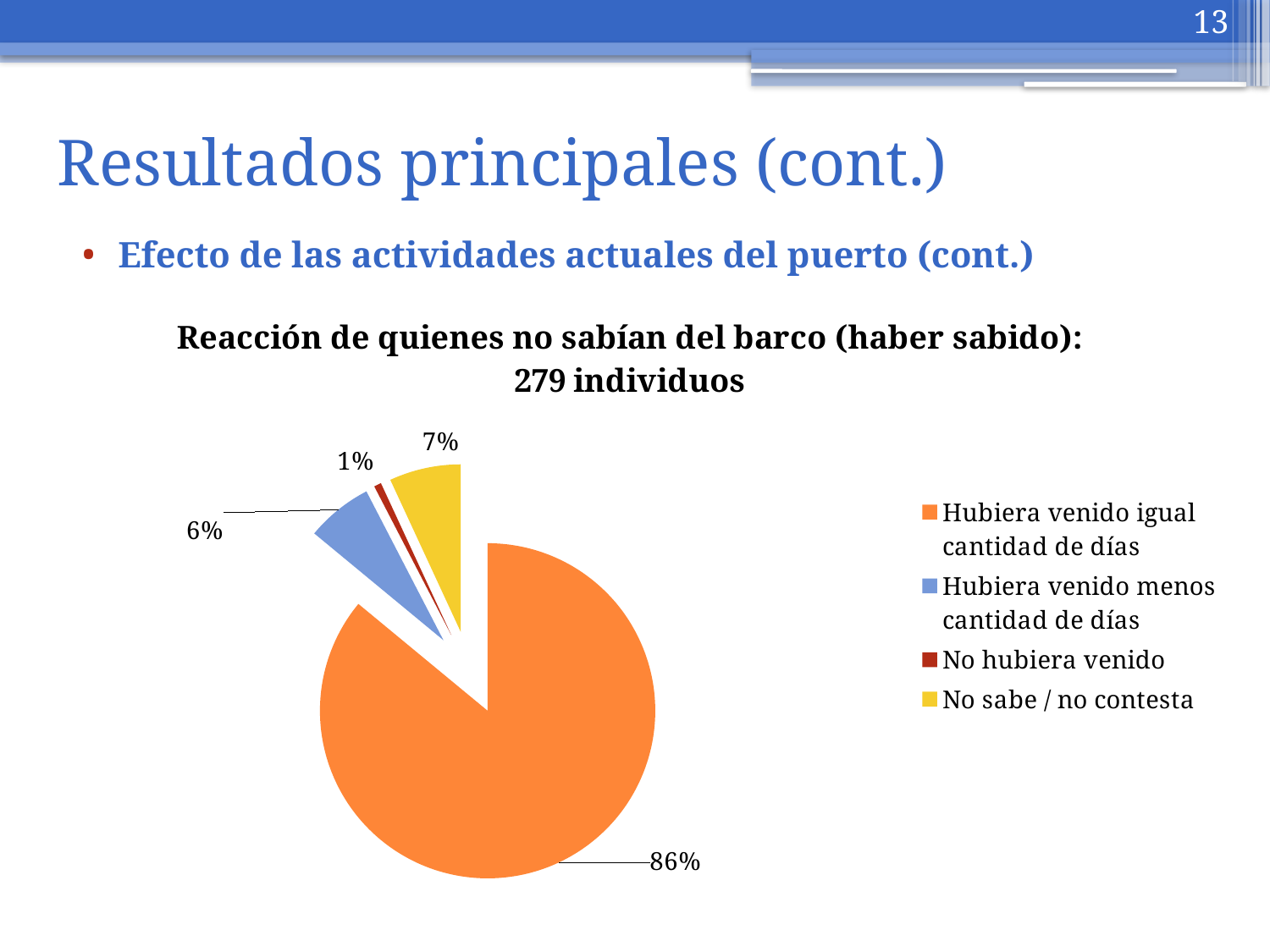
What type of chart is shown on the slide? Pie chart Which category has the smallest slice of the pie? No hubiera venido Which is larger: the slice for "No sabe / no contesta" or the slice for "Hubiera venido menos cantidad de días"? No sabe / no contesta Which category has the largest slice of the pie? Hubiera venido igual cantidad de días What is the value shown for "Hubiera venido menos cantidad de días"? 6% What is the difference in percentage points between "Hubiera venido igual cantidad de días" and "No sabe / no contesta"? 79 What is the value shown for "No sabe / no contesta"? 7% What share of the pie does "Hubiera venido igual cantidad de días" represent? 86% How many individuals does the chart title say the data is based on? 279 individuos What colour is the slice for "No hubiera venido"? Red What is the value shown for "No hubiera venido"? 1% How many categories does the pie chart show? 4